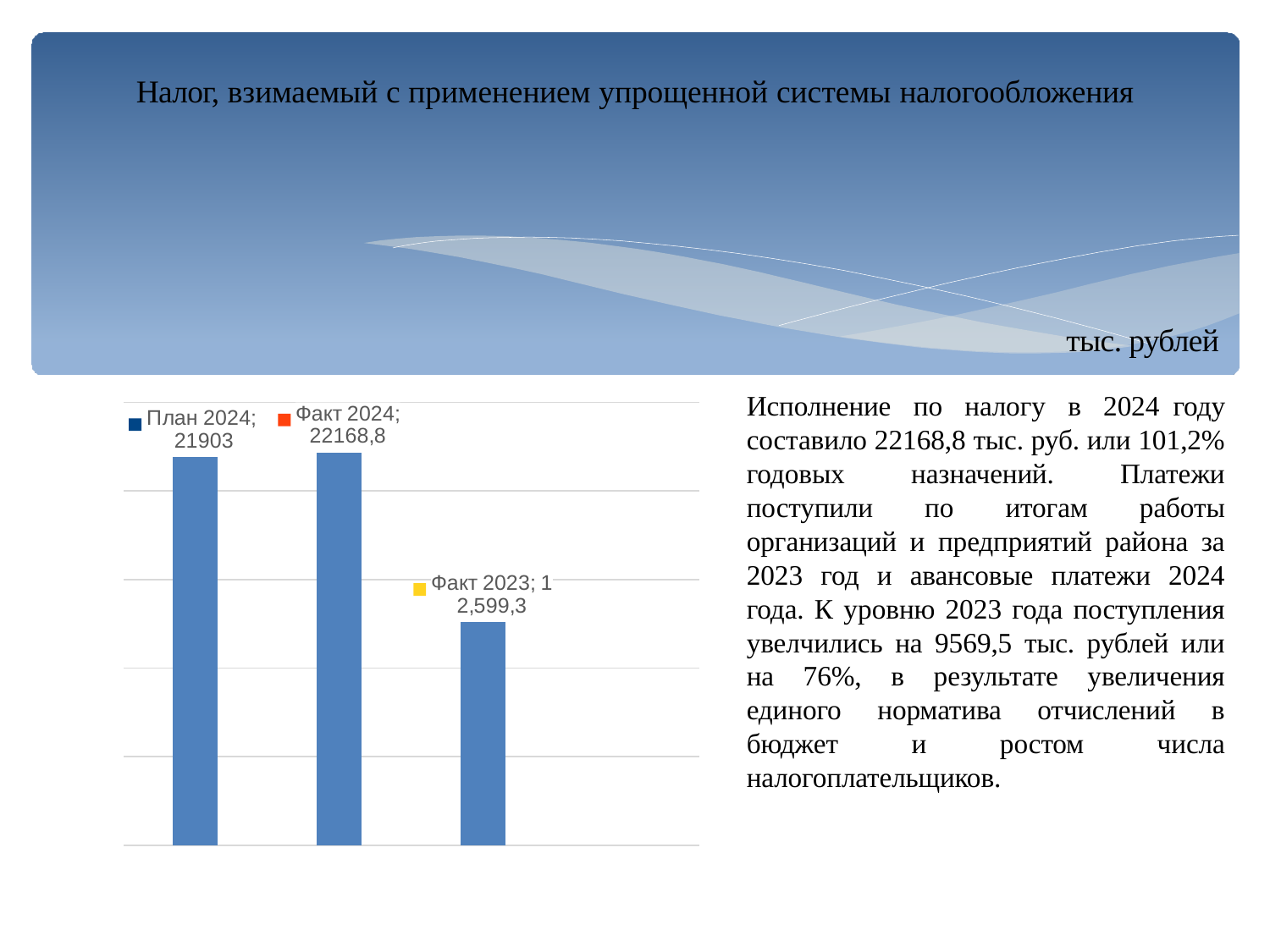
What is the difference between Факт 2024 and План 2024? 265,8 Which is larger, Факт 2023 or Факт 2024? Факт 2024 What kind of chart is shown on the slide? bar chart Which bar has the highest value? Факт 2024 What is the title of the slide above the chart? Налог, взимаемый с применением упрощенной системы налогообложения What is the value for Факт 2024? 22168,8 Which bar has the lowest value? Факт 2023 What is the value for План 2024? 21903 Which is larger, План 2024 or Факт 2024? Факт 2024 How many bars are plotted in the chart? 3 What unit of measurement is stated for the chart? тыс. рублей